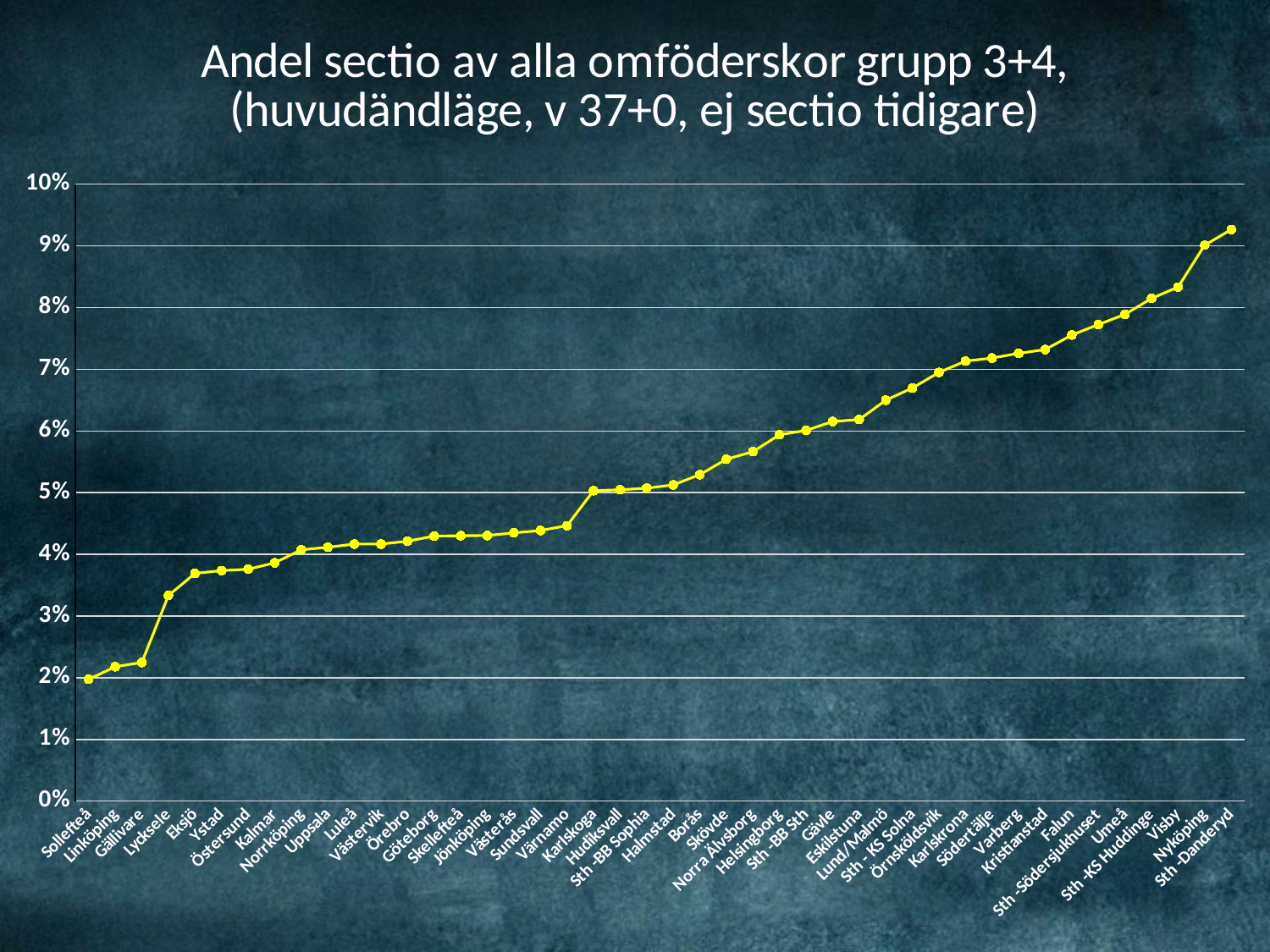
Which hospital has the lowest value in the chart? Sollefteå Is the value for Eksjö greater or less than 4%? less Which hospital has the highest value in the chart? Sth-Danderyd Is the value for Lycksele greater or less than 3%? greater Which has the larger value, Visby or Eksjö? Visby Is the value for Visby greater or less than 8%? greater What is the highest value shown on the vertical axis? 10% Do the values rise or fall from left to right along the x axis? rise Which has the larger value, Falun or Borås? Falun What kind of chart is shown on the slide? line chart